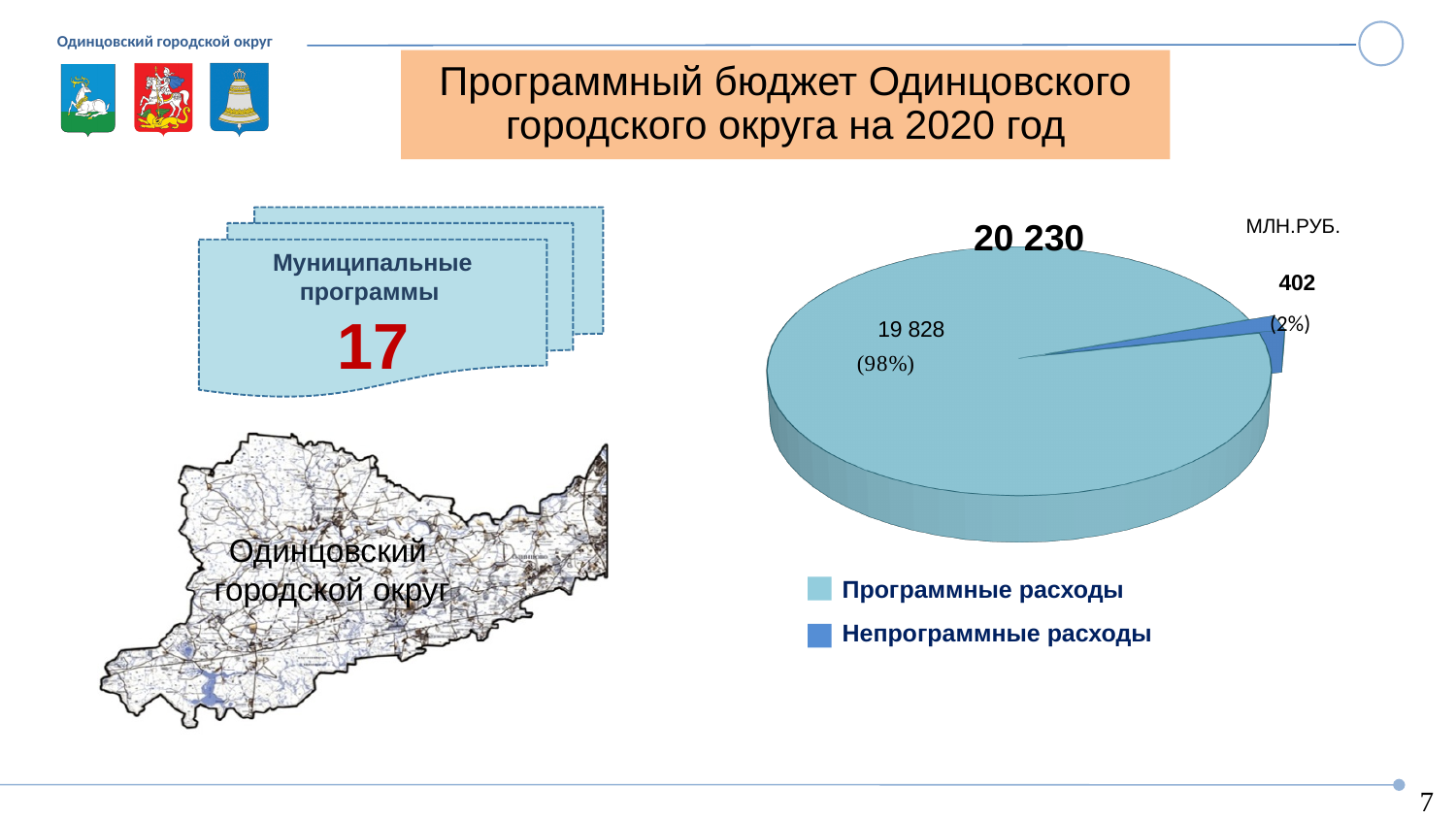
How many slices does the pie chart have? 2 What is the difference between Программные расходы and Непрограммные расходы? 19 426 What is the total value shown above the pie chart? 20 230 Which category has the largest slice in the pie chart? Программные расходы How many entries does the legend of the pie chart list? 2 What is the value for Программные расходы in the pie chart? 19 828 What kind of chart is shown on the slide? pie chart What is the value for Непрограммные расходы in the pie chart? 402 Which category has the smallest slice in the pie chart? Непрограммные расходы Which is larger, Программные расходы or Непрограммные расходы? Программные расходы What share of the pie does Программные расходы take? 98% What share of the pie does Непрограммные расходы take? 2%